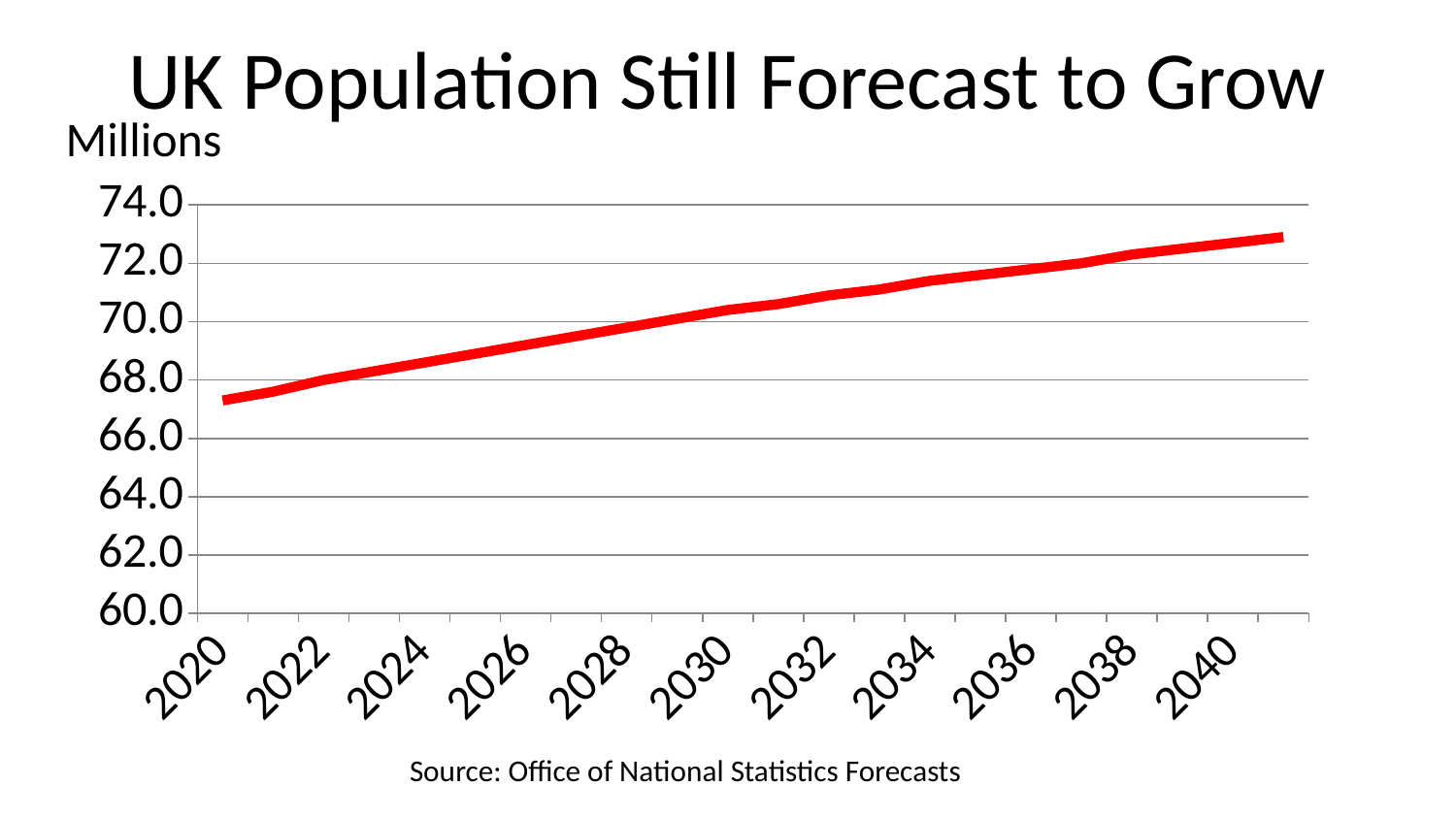
Is the value for 2034 greater or less than 72.0? less What unit is shown above the y axis? Millions How many year labels are shown on the x axis? 11 What kind of chart is shown on the slide? line chart Do the values rise or fall from 2020 to 2040? rise What is the title of the chart? UK Population Still Forecast to Grow Which is larger, the value for 2020 or the value for 2040? 2040 Is the value for 2020 greater or less than 68.0? less Is the value for 2024 greater or less than 68.0? greater Which labelled year has the lowest value on the line? 2020